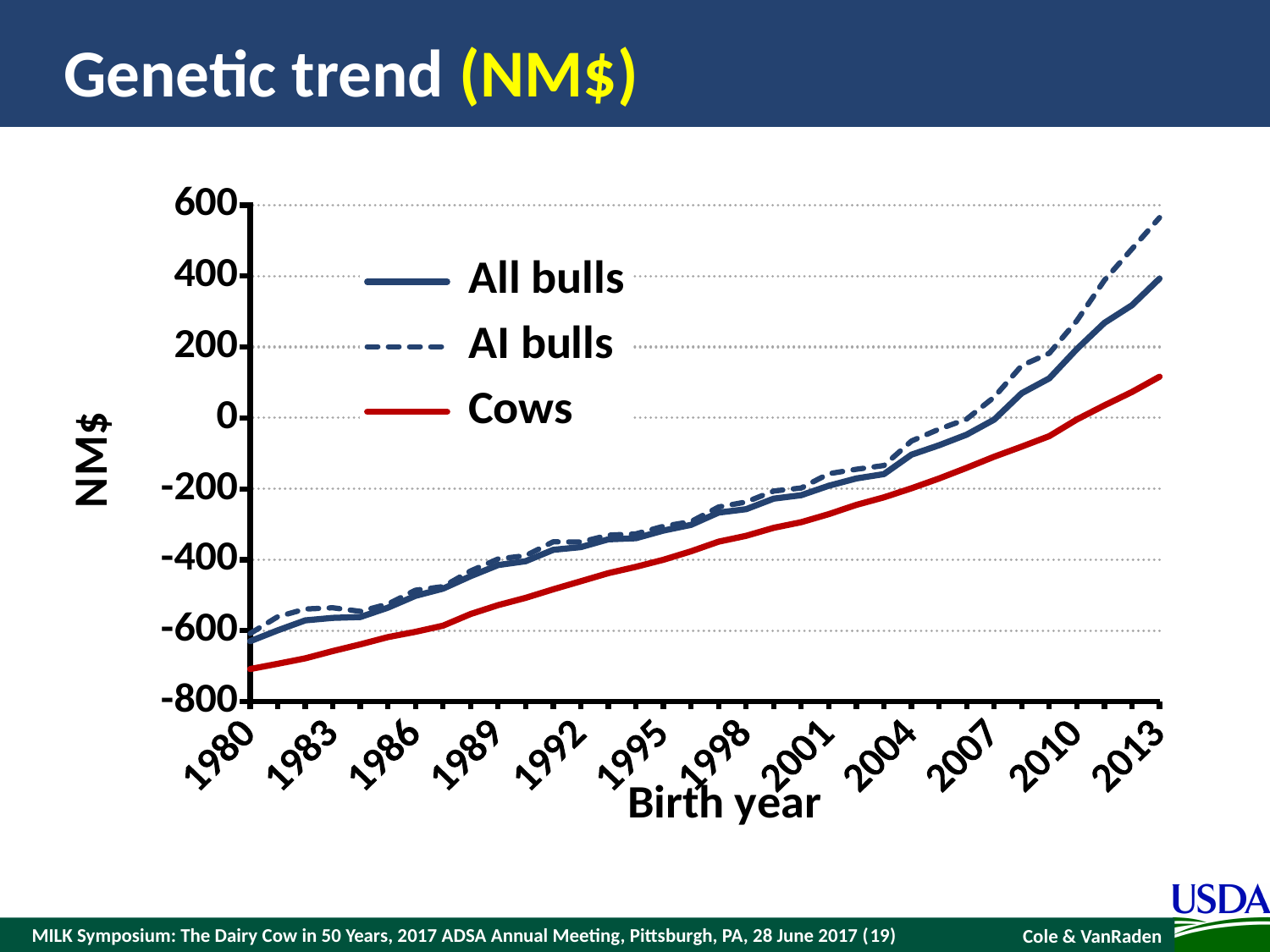
Is the value for AI bulls in 2013 greater or less than 400? greater What is the label of the x axis? Birth year Which series is drawn with a dashed line? AI bulls Is the value for All bulls in 1995 greater or less than -200? less Do the values for Cows rise or fall from 1980 to 2013? rise Is the value for Cows in 1980 greater or less than -600? less Which series has the highest value in 2013? AI bulls How many series does the legend list? 3 What kind of chart is shown on the slide? line chart Which series has the lowest value in 2013? Cows In 1980, which is larger: the value for All bulls or the value for Cows? All bulls